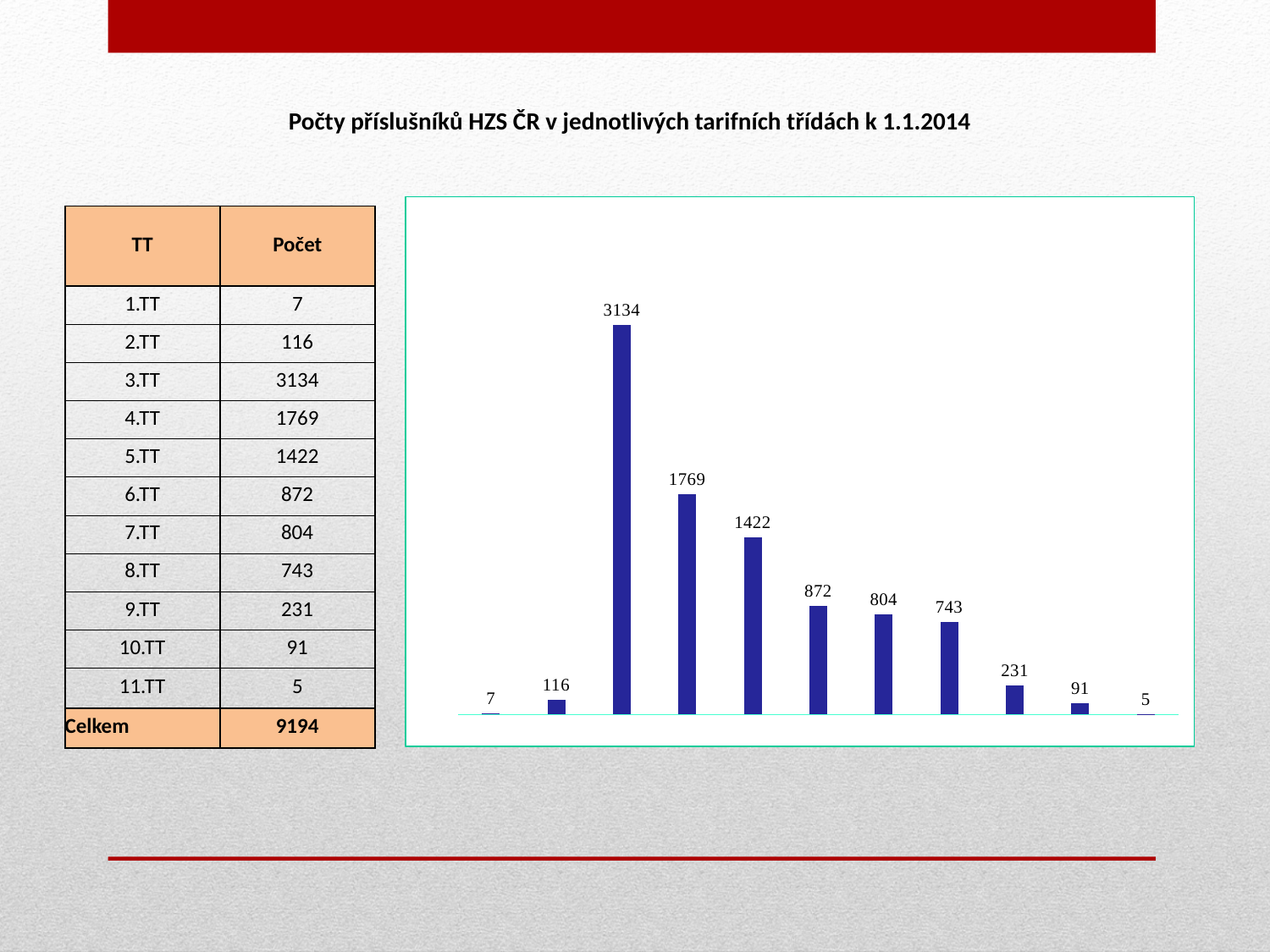
What is the value labelled on the tallest bar in the chart? 3134 What is the difference between the values labelled 804 and 743 on the chart? 61 What value is labelled on the third bar from the left? 3134 How many bars does the chart contain? 11 What is the difference between the values of the third bar (3134) and the fourth bar (1769)? 1365 Which is larger, the value of the sixth bar (872) or the seventh bar (804)? 872 What value is labelled on the ninth bar from the left? 231 What colour are the bars in the chart? dark blue What value is labelled on the fourth bar from the left? 1769 Do the bar values rise or fall from the fourth bar to the eleventh bar? fall What type of chart is shown on the slide? bar chart What is the value labelled on the shortest bar in the chart? 5